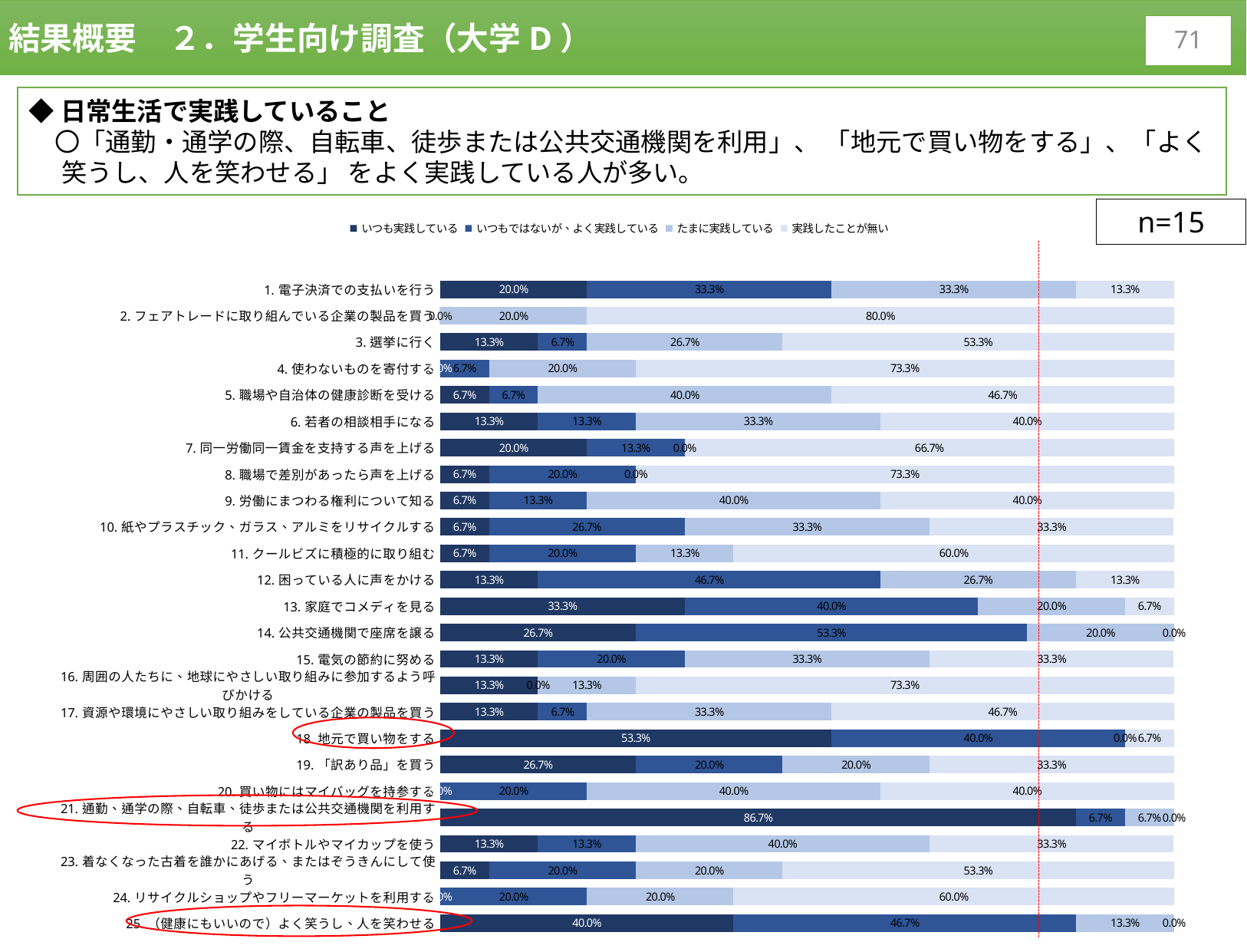
Which item has the highest value for 「実践したことが無い」? 2. フェアトレードに取り組んでいる企業の製品を買う What is the value of 「実践したことが無い」 for item 3 (選挙に行く)? 53.3% What kind of chart is shown on the slide? bar chart How many series does the legend list? 4 What is the value of 「いつも実践している」 for item 18 (地元で買い物をする)? 53.3% What is the value of 「いつもではないが、よく実践している」 for item 25 (よく笑うし、人を笑わせる)? 46.7% What is the difference between the 「いつも実践している」 values for item 21 (通勤・通学) and item 18 (地元で買い物をする)? 33.4% Which is larger: the 「いつも実践している」 value for item 13 (家庭でコメディを見る) or for item 14 (公共交通機関で座席を譲る)? 13. 家庭でコメディを見る How many categories (items) are plotted in the chart? 25 What sample size (n) is shown on the slide? n=15 What is the value of 「いつも実践している」 for item 21 (通勤、通学の際、自転車、徒歩または公共交通機関を利用する)? 86.7% Which item has the highest value for 「いつも実践している」? 21. 通勤、通学の際、自転車、徒歩または公共交通機関を利用する